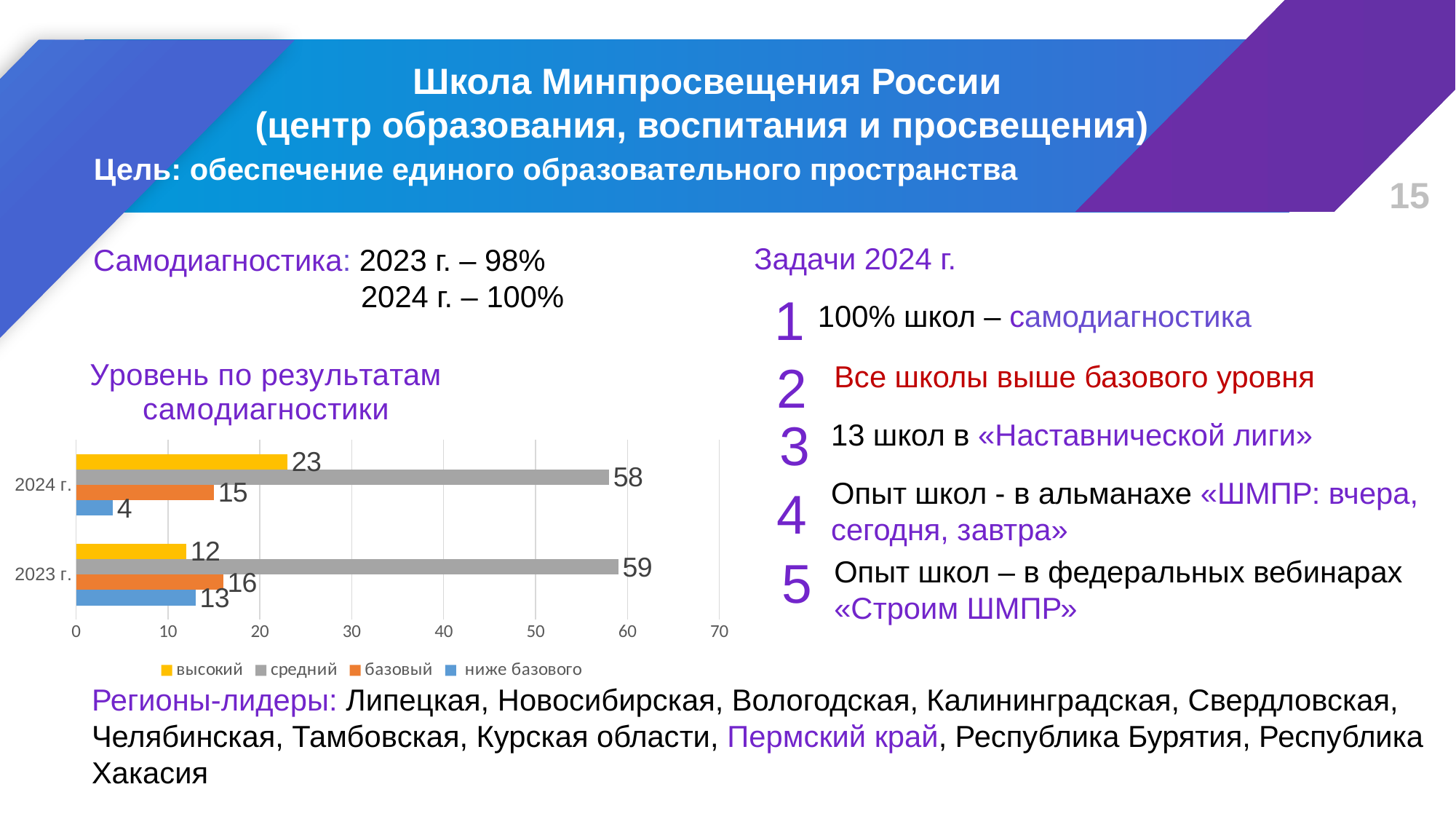
What is the value for «высокий» in 2024 г.? 23 What is the value for «ниже базового» in 2023 г.? 13 What is the value for «средний» in 2024 г.? 58 Which series has the highest value in 2024 г.? средний What kind of chart is shown on the slide? bar chart What is the difference between the «высокий» values for 2024 г. and 2023 г.? 11 How many series does the legend list? 4 What is the value for «базовый» in 2023 г.? 16 Which series has the lowest value in 2024 г.? ниже базового What is the title of the chart? Уровень по результатам самодиагностики Which is larger: «ниже базового» in 2023 г. or «ниже базового» in 2024 г.? 2023 г. How many categories (years) are shown on the chart? 2